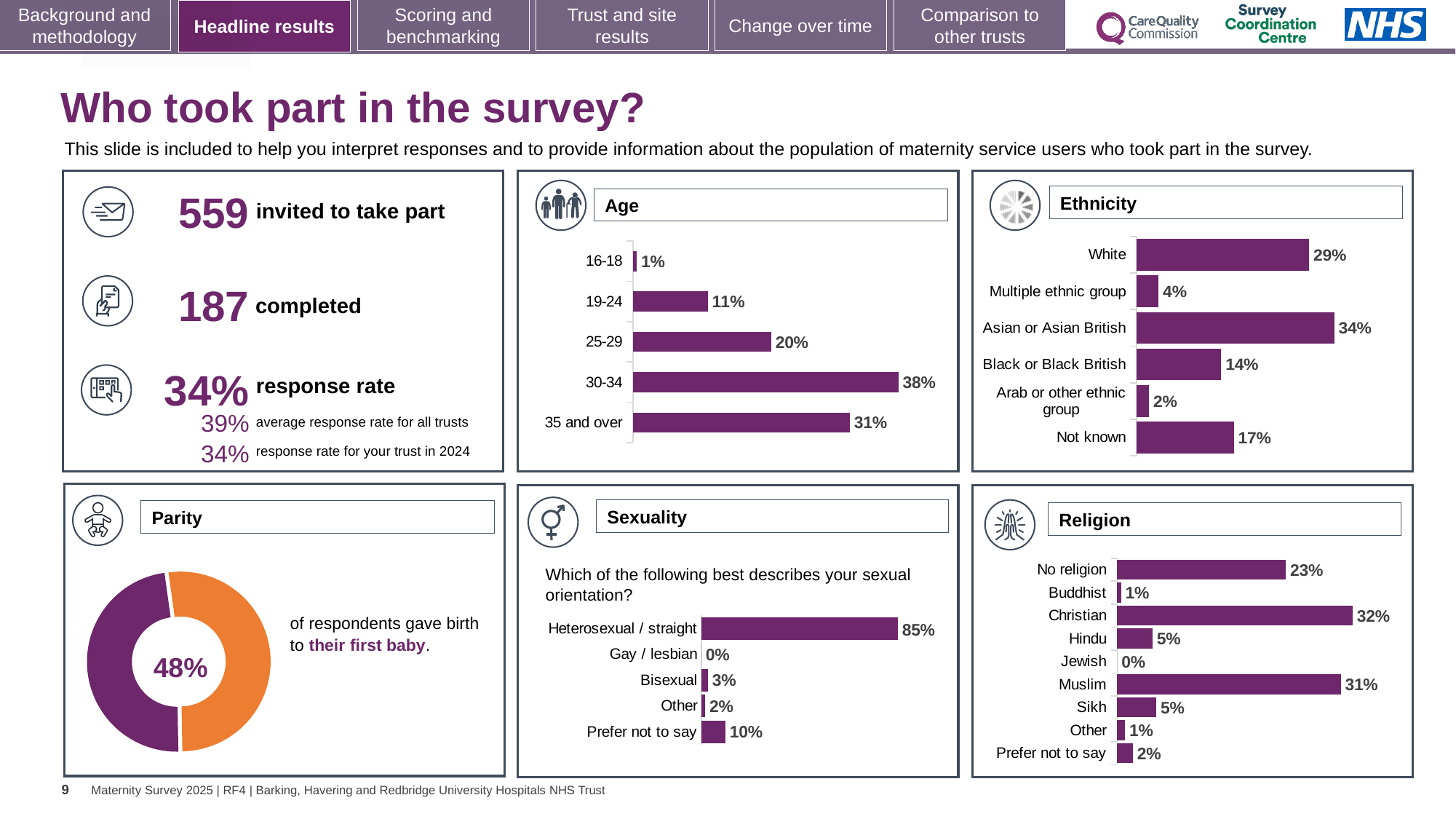
In the Sexuality chart, what percentage of respondents answered Prefer not to say? 10% In the Age chart, what percentage of respondents were aged 30-34? 38% In the Ethnicity chart, which category has the highest percentage? Asian or Asian British In the Ethnicity chart, what is the difference between the percentages for White and Black or Black British? 15% In the Religion chart, how many categories are shown? 9 In the Sexuality chart, what is the difference between the percentages for Heterosexual / straight and Bisexual? 82% In the Parity chart, what share of respondents gave birth to their first baby? 48% In the Age chart, which age group has the lowest percentage? 16-18 In the Ethnicity chart, how many categories are shown? 6 What type of chart is used in the Parity panel? Doughnut chart In the Religion chart, what percentage of respondents were Muslim? 31% In the Religion chart, which is larger, the percentage for Christian or the percentage for No religion? Christian